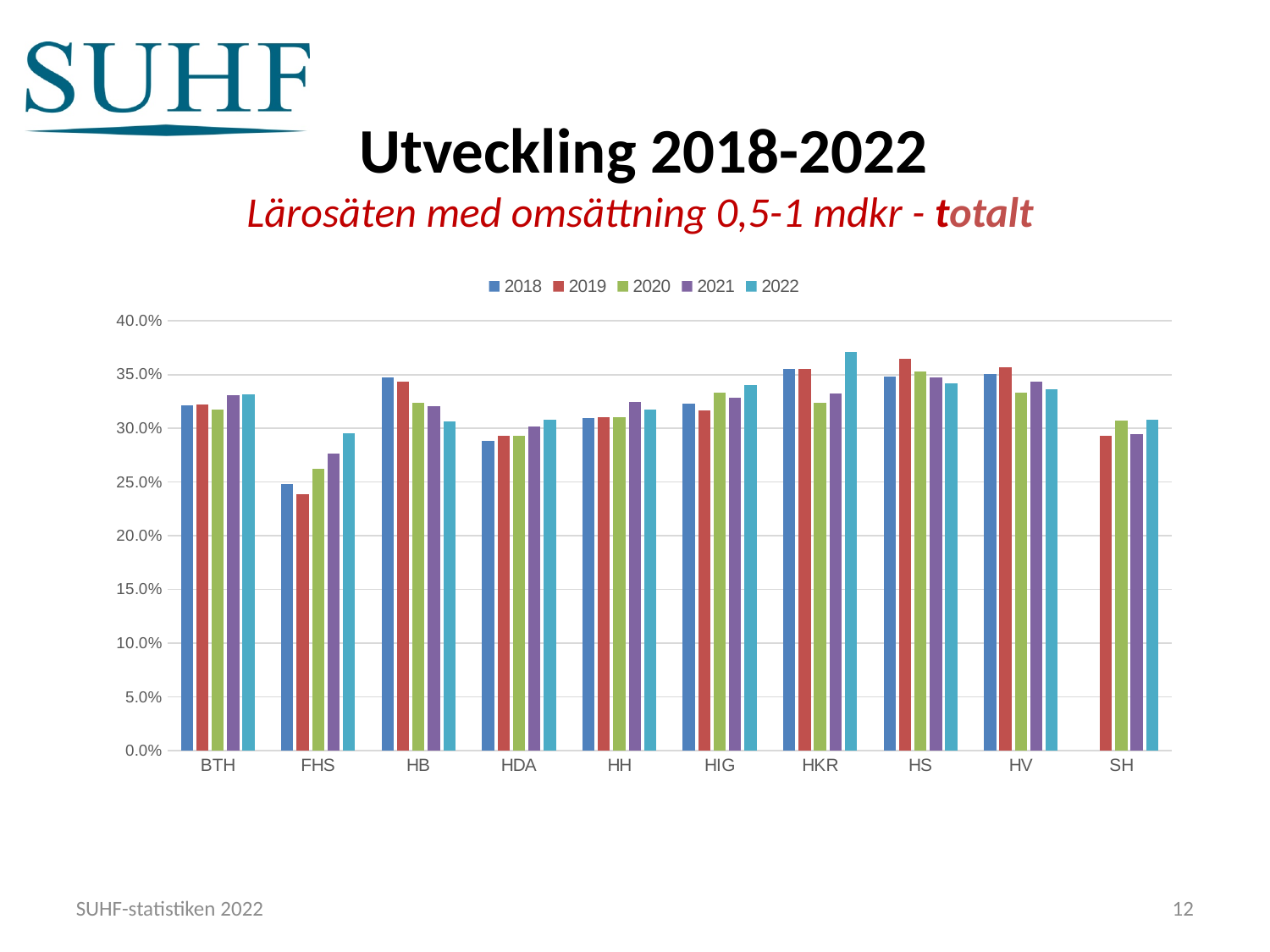
Is the value for HS in 2019 greater or less than 35%? greater How many series does the legend list? 5 Is the value for HKR in 2022 greater or less than 35%? greater What kind of chart is shown on the slide? bar chart Is the value for FHS in 2019 greater or less than 25%? less Which category has the lowest value for 2019? FHS What is the main title of the chart slide? Utveckling 2018-2022 How many categories (institutions) are shown on the x axis? 10 Which category has the highest value for 2022? HKR Do the values for HB rise or fall from 2018 to 2022? fall Which is larger for 2022: FHS or HKR? HKR